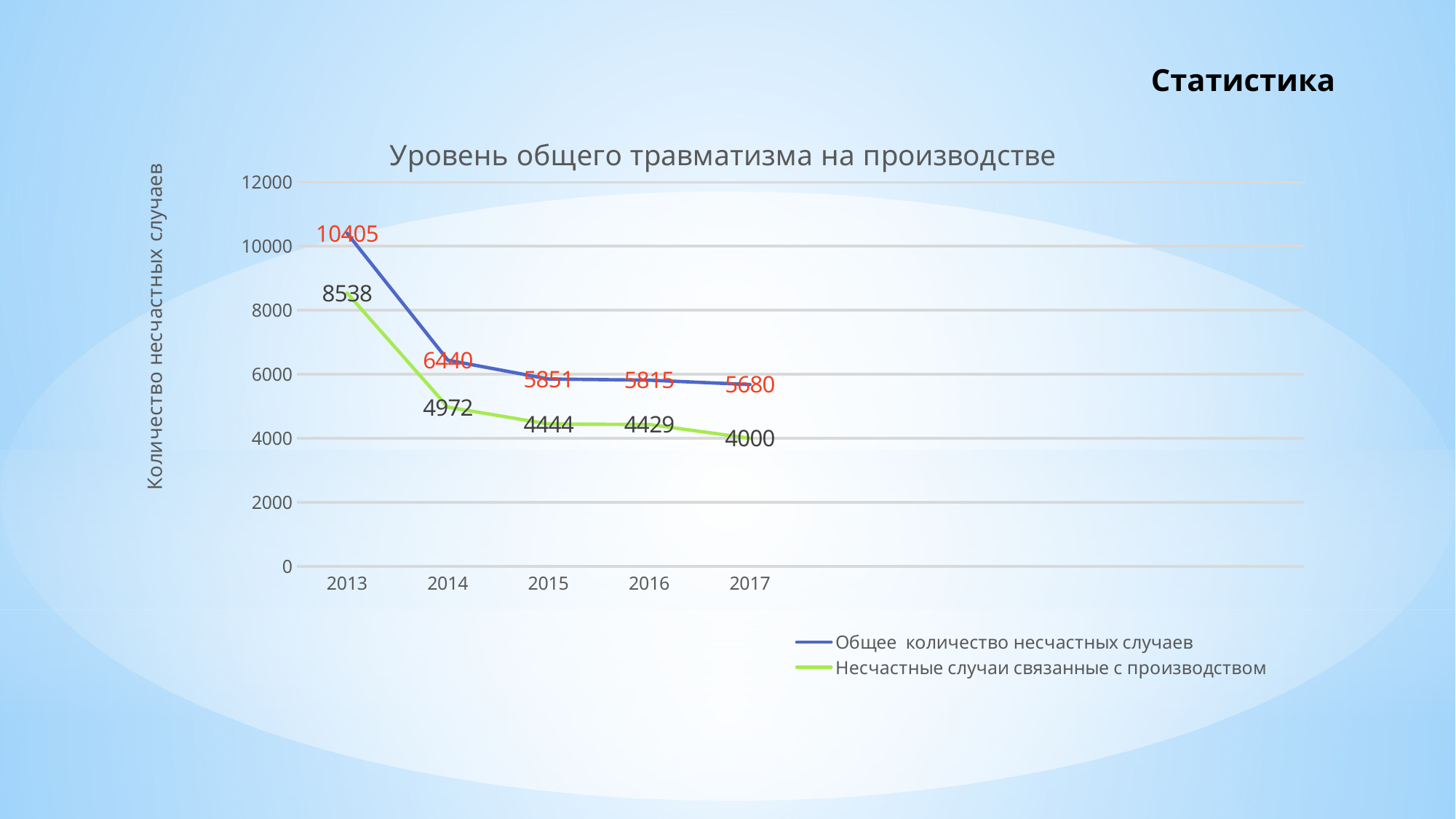
How many years are shown on the x axis? 5 What is the value for 'Несчастные случаи связанные с производством' in 2014? 4972 Do the values for 'Общее количество несчастных случаев' rise or fall from 2013 to 2017? fall In which year is 'Несчастные случаи связанные с производством' lowest? 2017 Which is larger: 'Общее количество несчастных случаев' in 2014 or 'Несчастные случаи связанные с производством' in 2013? Несчастные случаи связанные с производством in 2013 What is the value for 'Общее количество несчастных случаев' in 2013? 10405 What is the value for 'Несчастные случаи связанные с производством' in 2017? 4000 What kind of chart is shown? line chart What is the difference between 'Общее количество несчастных случаев' and 'Несчастные случаи связанные с производством' in 2016? 1386 How many series does the legend list? 2 What is the value for 'Общее количество несчастных случаев' in 2015? 5851 In which year is 'Общее количество несчастных случаев' highest? 2013